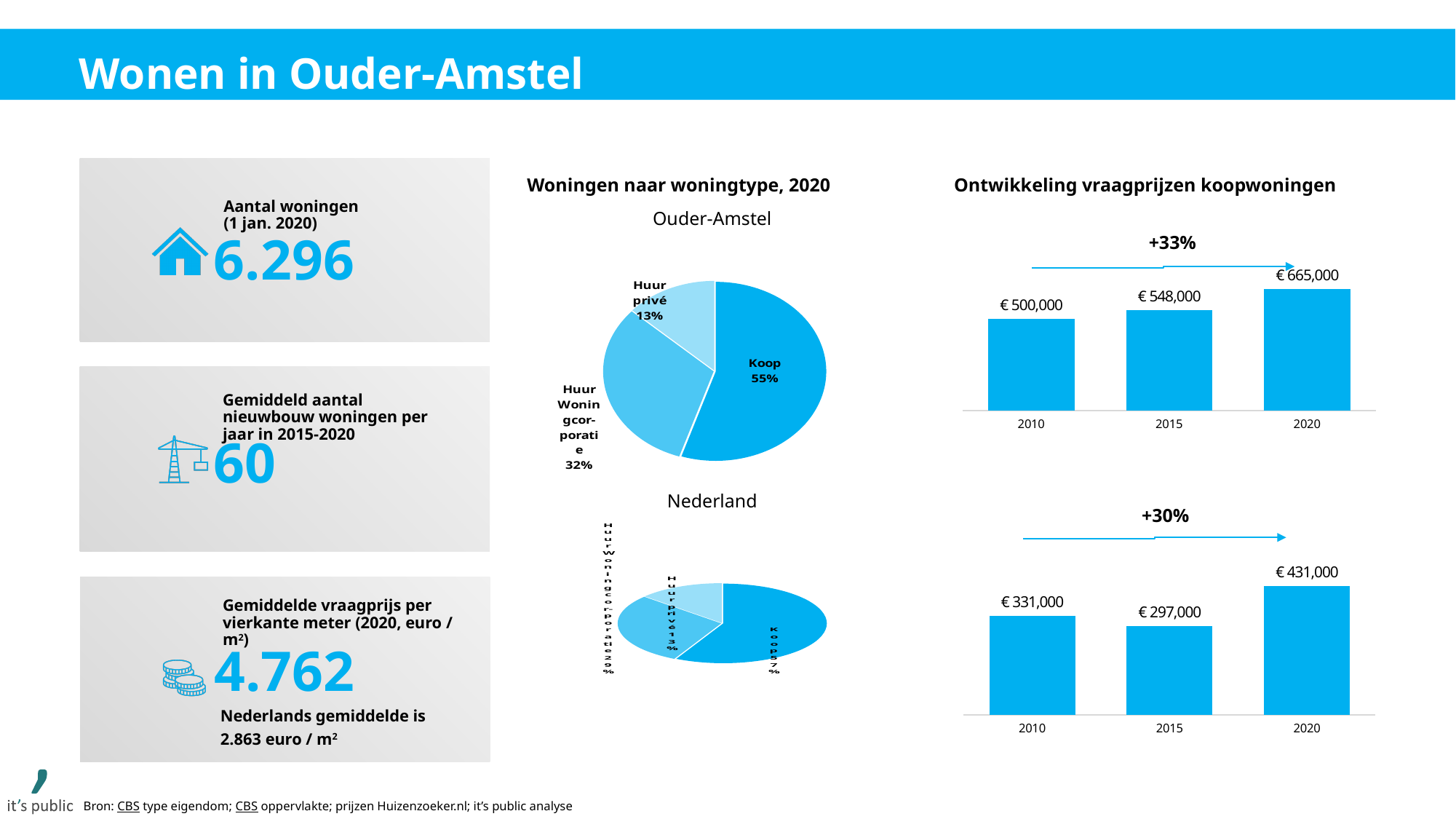
In the lower bar chart on the right, is the value for 2010 larger or smaller than the value for 2020? smaller In the upper bar chart on the right, what is the value for 2010? € 500,000 In the Ouder-Amstel pie chart, how many slices are there? 3 In the Ouder-Amstel pie chart, what share of homes is Huur privé? 13% In the Ouder-Amstel pie chart, what is the difference in percentage points between Koop and Huur Woningcorporatie? 23 In the lower bar chart on the right, which year has the lowest value? 2015 In the Ouder-Amstel pie chart, what share of homes is Koop? 55% In the lower bar chart on the right, what is the value for 2015? € 297,000 In the Ouder-Amstel pie chart, which category has the largest share? Koop In the upper bar chart on the right, what is the difference between the 2020 and 2015 values? € 117,000 In the Ouder-Amstel pie chart, which category has the smallest share? Huur privé In the upper bar chart on the right, what is the value for 2020? € 665,000